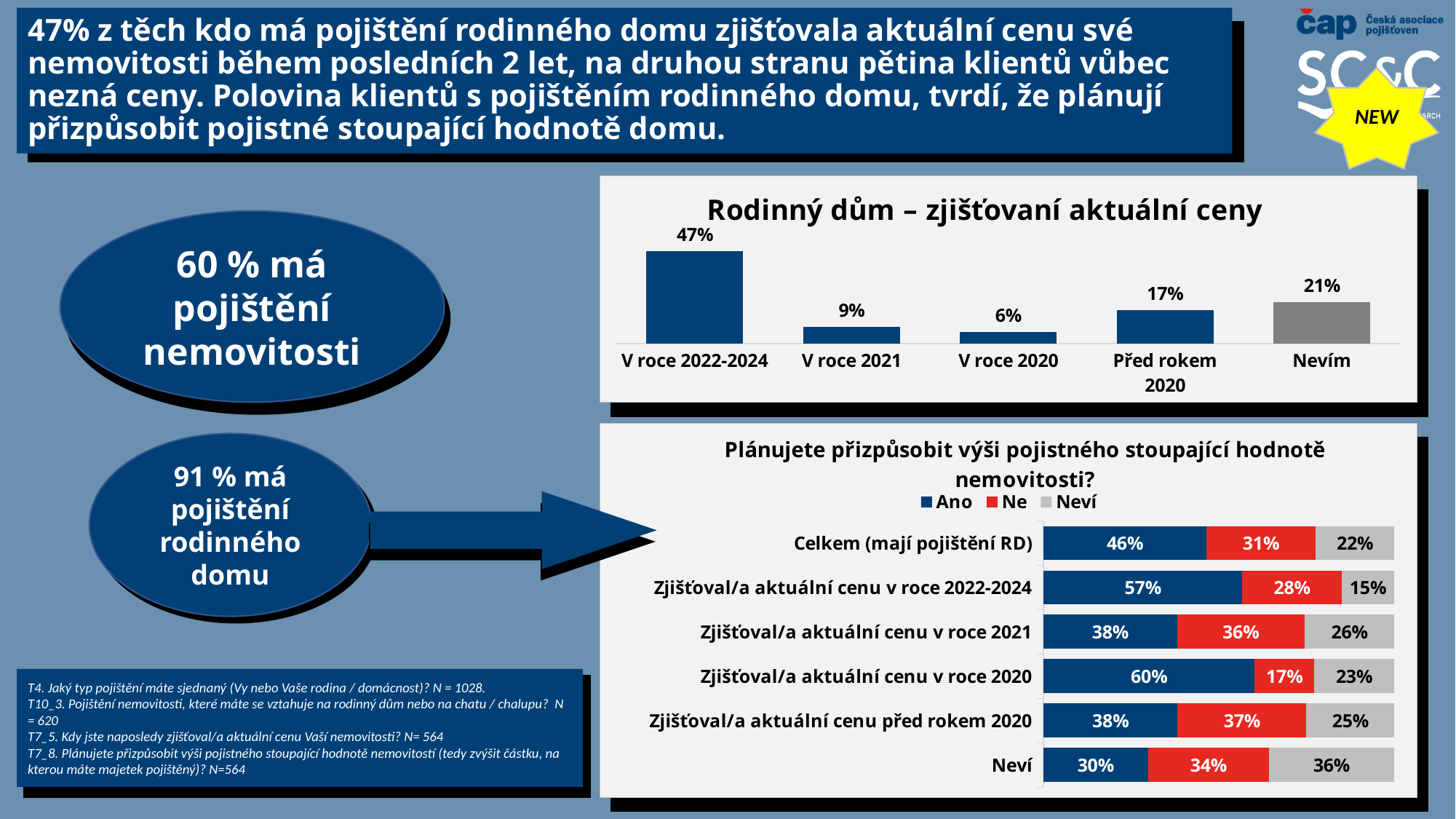
In the chart 'Rodinný dům – zjišťovaní aktuální ceny', which is larger: 'V roce 2021' or 'Před rokem 2020'? Před rokem 2020 In the chart 'Plánujete přizpůsobit výši pojistného stoupající hodnotě nemovitosti?', what is the difference between the 'Ne' values for 'Zjišťoval/a aktuální cenu před rokem 2020' and 'Zjišťoval/a aktuální cenu v roce 2020'? 20% In the chart 'Plánujete přizpůsobit výši pojistného stoupající hodnotě nemovitosti?', what is the 'Neví' value for 'Celkem (mají pojištění RD)'? 22% In the chart 'Rodinný dům – zjišťovaní aktuální ceny', which category has the lowest value? V roce 2020 In the chart 'Plánujete přizpůsobit výši pojistného stoupající hodnotě nemovitosti?', what is the 'Ano' value for 'Zjišťoval/a aktuální cenu v roce 2020'? 60% In the chart 'Plánujete přizpůsobit výši pojistného stoupající hodnotě nemovitosti?', how many series does the legend list? 3 In the chart 'Rodinný dům – zjišťovaní aktuální ceny', how many categories are shown? 5 In the chart 'Rodinný dům – zjišťovaní aktuální ceny', what is the value for 'V roce 2022-2024'? 47% What kind of chart is 'Rodinný dům – zjišťovaní aktuální ceny'? Bar chart In the chart 'Plánujete přizpůsobit výši pojistného stoupající hodnotě nemovitosti?', what colour represents the 'Ne' series? Red In the chart 'Plánujete přizpůsobit výši pojistného stoupající hodnotě nemovitosti?', which category has the highest 'Ano' value? Zjišťoval/a aktuální cenu v roce 2020 In the chart 'Rodinný dům – zjišťovaní aktuální ceny', what is the difference between 'Nevím' and 'Před rokem 2020'? 4%